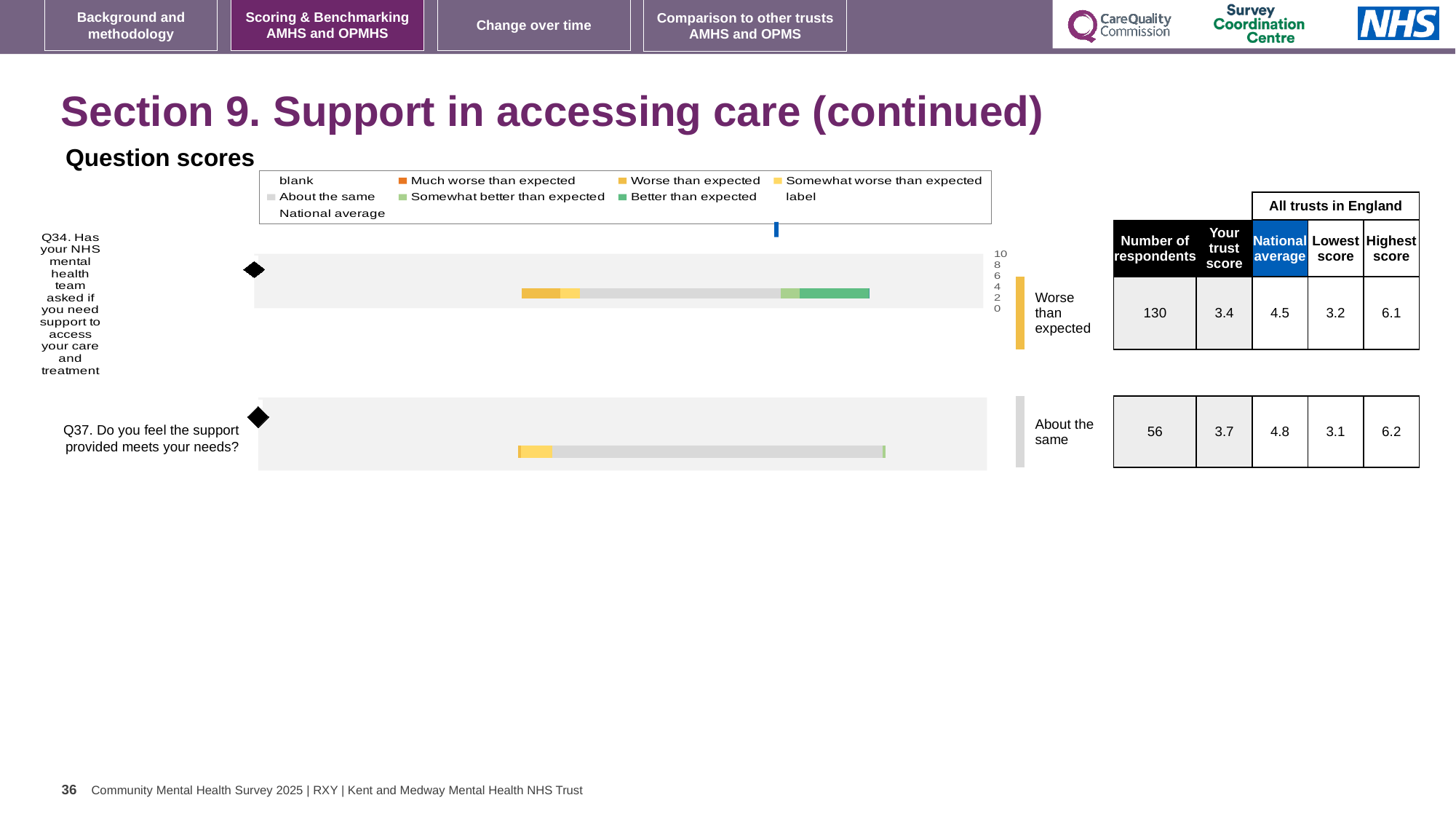
Which benchmark category is shown next to the bar for Q37 (Do you feel the support provided meets your needs)? About the same Which question has the higher trust score, Q34 or Q37? Q37 Which benchmark category is shown next to the bar for Q34 (Has your NHS mental health team asked if you need support to access your care and treatment)? Worse than expected What kind of chart is used to show the question scores on this slide? bar chart What is the number of respondents for Q34? 130 How many questions (categories) are plotted in the question scores chart? 2 What is the highest score among all trusts in England for Q37? 6.2 Which question has the lower number of respondents, Q34 or Q37? Q37 What is the difference between the national average and the trust score for Q34? 1.1 What is the national average score for Q34? 4.5 What is the trust score for Q37 (Do you feel the support provided meets your needs)? 3.7 How many entries does the legend of the question scores chart list? 9